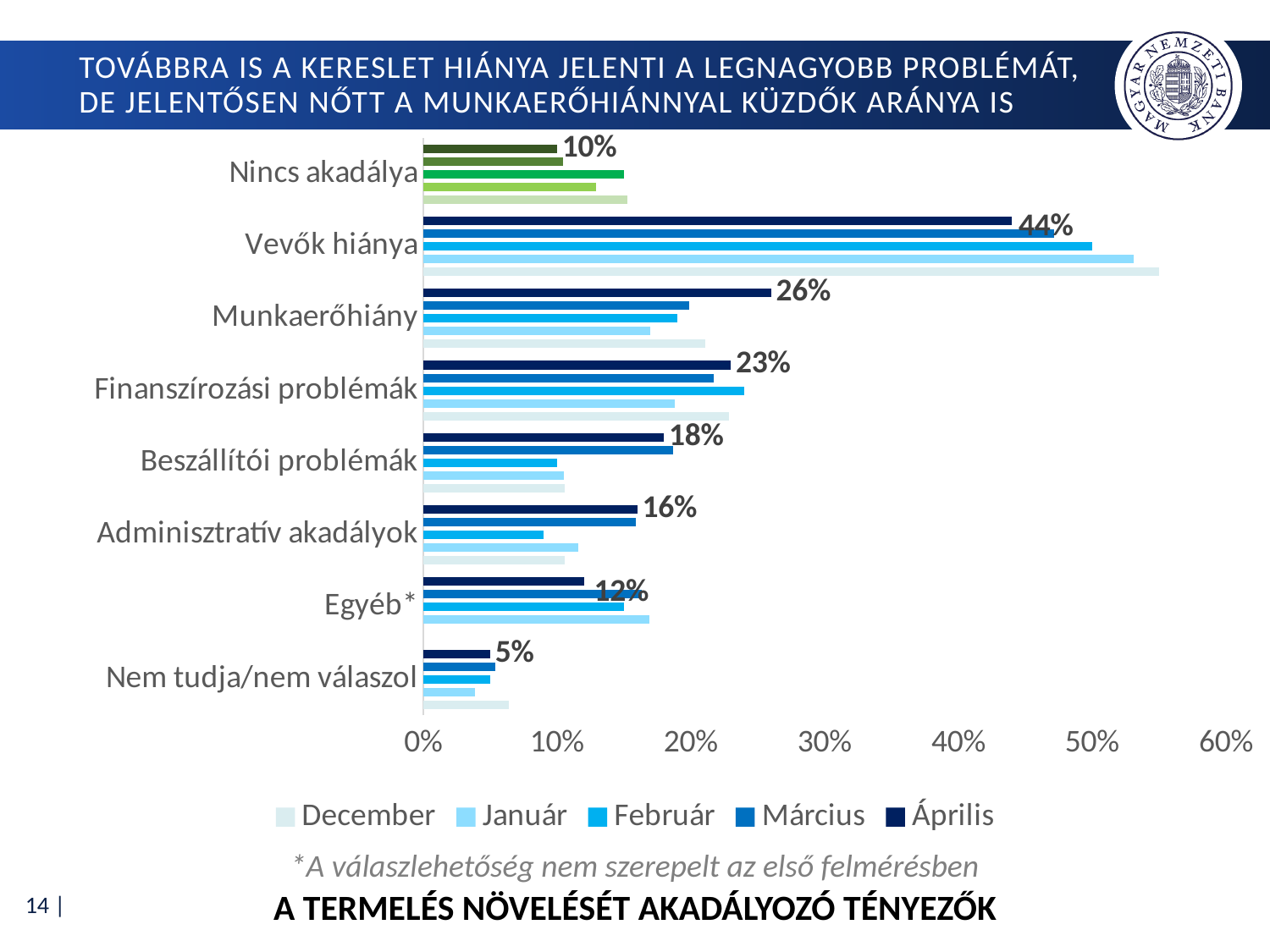
How many categories are shown on the chart? 8 Which category has the highest Április value? Vevők hiánya Which category has the lowest Április value? Nem tudja/nem válaszol What is the Április value for Vevők hiánya? 44% Is the December value for Nincs akadálya greater or less than 20%? less What kind of chart is shown on the slide? Bar chart What is the difference between the Április values for Vevők hiánya and Munkaerőhiány? 18 percentage points What is the Április value for Munkaerőhiány? 26% How many series does the legend list? 5 What is the Április value for Nem tudja/nem válaszol? 5% Which has the larger Április value: Finanszírozási problémák or Beszállítói problémák? Finanszírozási problémák Is the December value for Vevők hiánya greater or less than 50%? greater